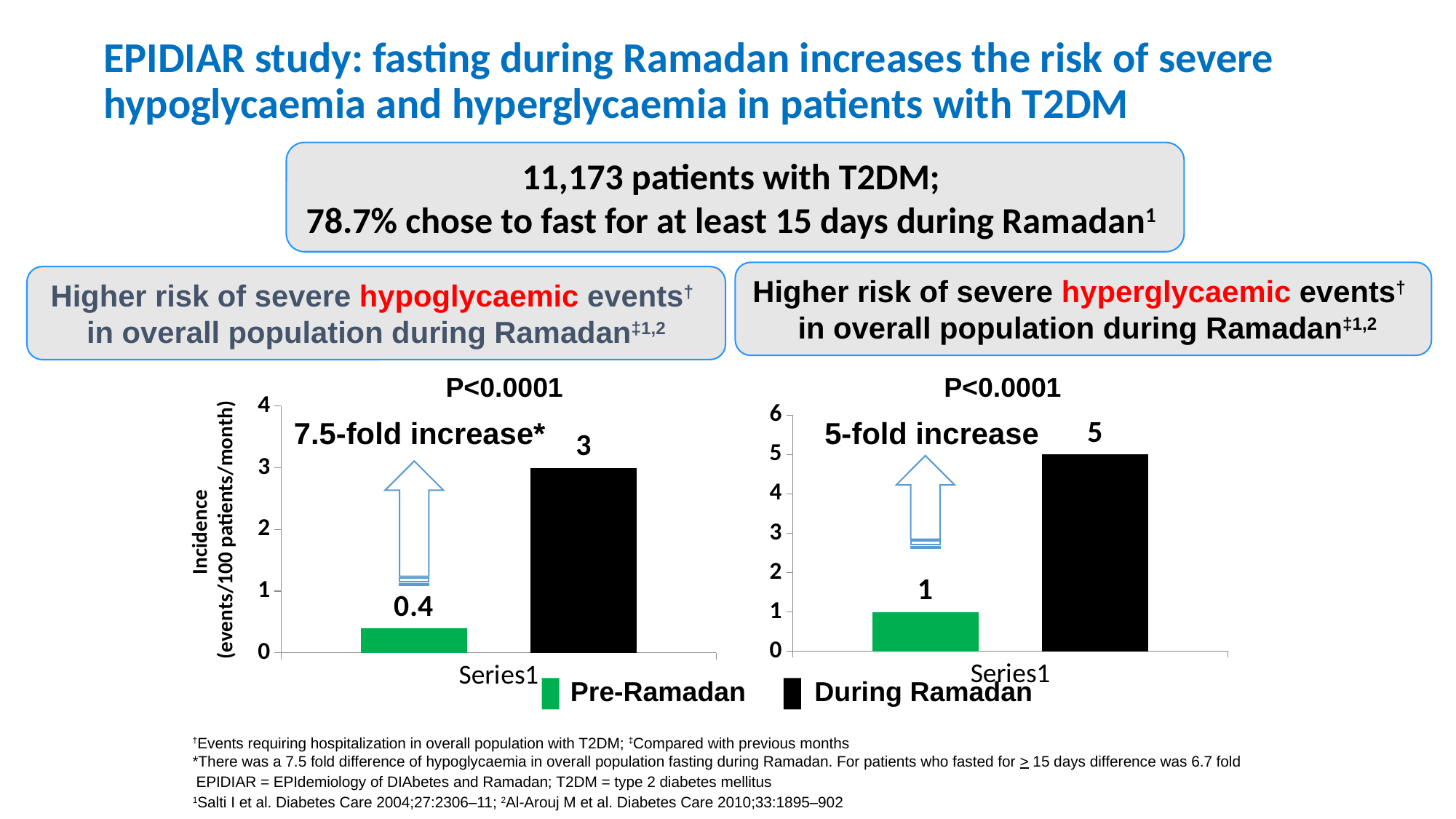
What type of chart is used on the left for hypoglycaemic events? Bar chart What colour is the Pre-Ramadan bar in the charts? Green What is the y-axis label of the left chart (hypoglycaemic events)? Incidence (events/100 patients/month) In the right chart (hyperglycaemic events), what is the incidence value for During Ramadan? 5 In the left chart (hypoglycaemic events), what is the incidence value for During Ramadan? 3 How many series does the shared legend below the charts list? 2 In the left chart (hypoglycaemic events), what is the difference between the During Ramadan and Pre-Ramadan values? 2.6 In the right chart (hyperglycaemic events), which bar is higher, Pre-Ramadan or During Ramadan? During Ramadan In the right chart (hyperglycaemic events), what is the difference between the During Ramadan and Pre-Ramadan values? 4 In the left chart (hypoglycaemic events), what is the incidence value for Pre-Ramadan? 0.4 In the right chart (hyperglycaemic events), what is the incidence value for Pre-Ramadan? 1 In the left chart (hypoglycaemic events), which series has the lowest value? Pre-Ramadan